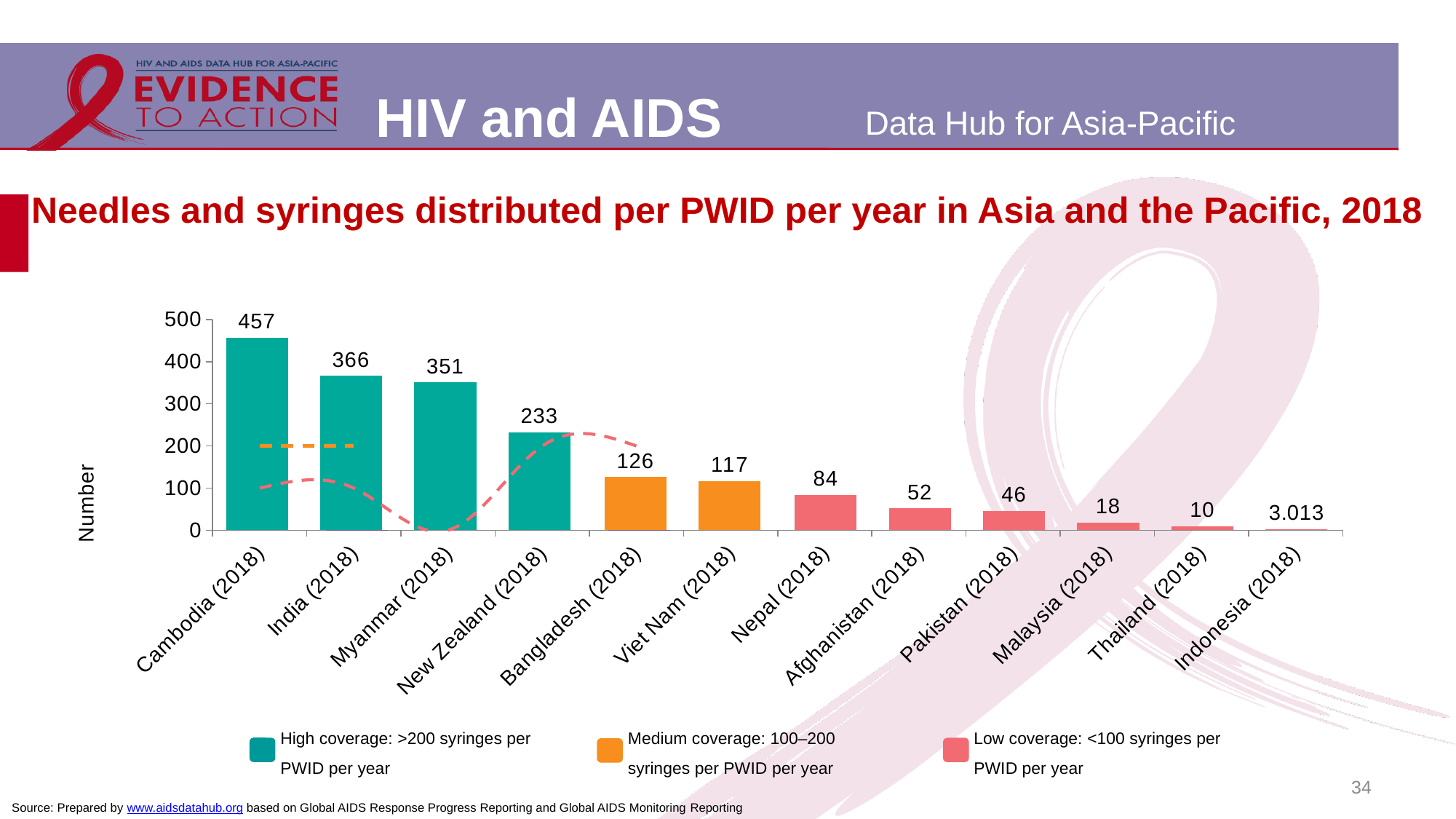
What is the value for Malaysia (2018)? 18 What is the difference between the values for India (2018) and Myanmar (2018)? 15 How many countries are shown on the chart? 12 What kind of chart is shown on the slide? Bar chart Which coverage category does the legend associate with the orange bars? Medium coverage: 100–200 syringes per PWID per year What is the value for Bangladesh (2018)? 126 What is the value for Cambodia (2018)? 457 How many coverage categories does the legend list? 3 Which country has the lowest number of needles and syringes distributed per PWID per year? Indonesia (2018) Is the value for New Zealand (2018) greater or less than 200? greater Which country has the highest number of needles and syringes distributed per PWID per year? Cambodia (2018) Which is larger, the value for Viet Nam (2018) or Nepal (2018)? Viet Nam (2018)